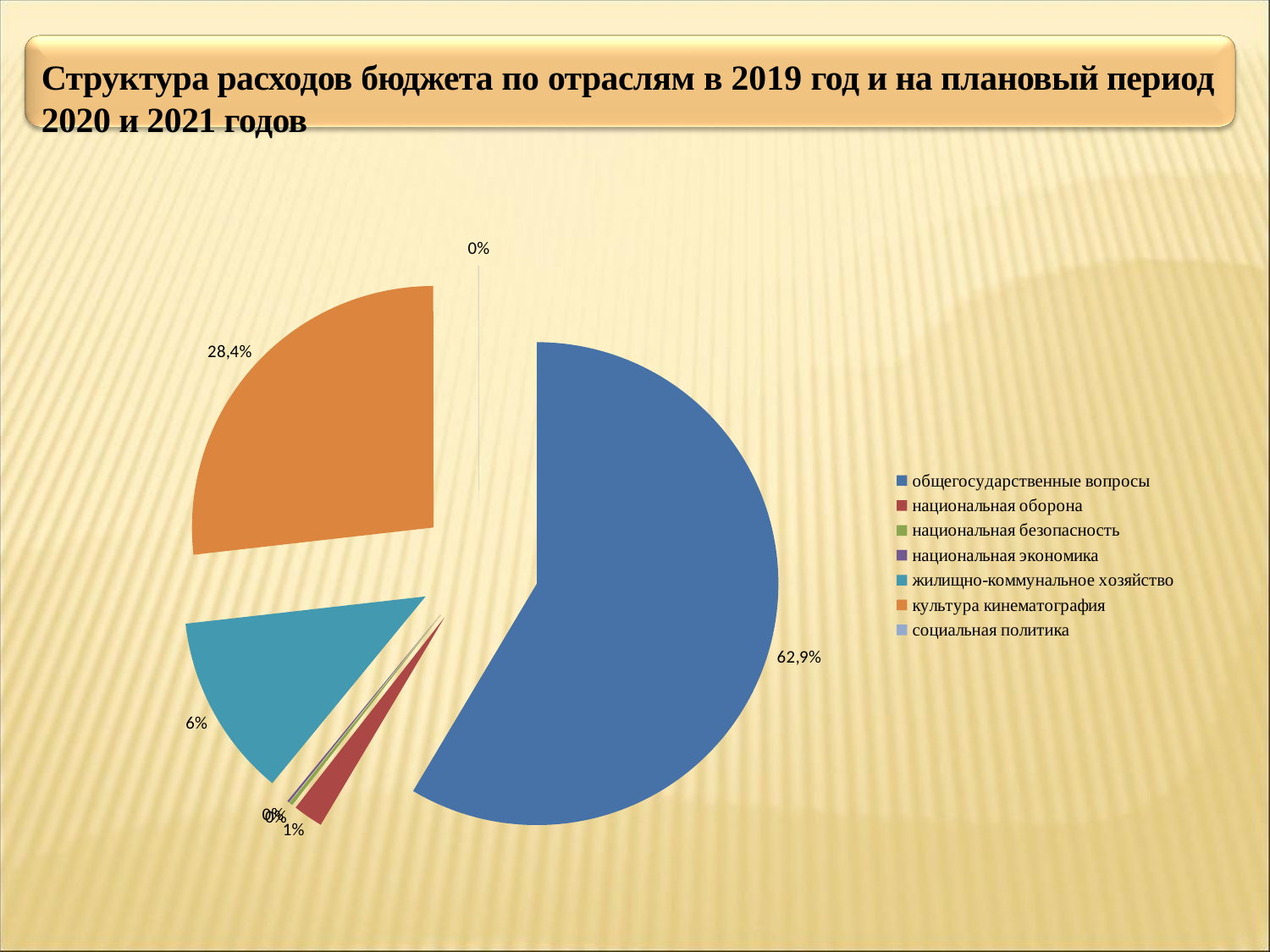
How many categories does the legend list? 7 What colour is the slice for культура кинематография? orange What share of the pie does общегосударственные вопросы take? 62,9% What share of the pie does национальная оборона take? 1% What is the title of the slide? Структура расходов бюджета по отраслям в 2019 год и на плановый период 2020 и 2021 годов What share of the pie does жилищно-коммунальное хозяйство take? 6% What kind of chart is shown on the slide? pie chart Which is larger: the share of культура кинематография or the share of жилищно-коммунальное хозяйство? культура кинематография What share of the pie does культура кинематография take? 28,4% Which category has the largest slice of the pie? общегосударственные вопросы What share of the pie does социальная политика take? 0% What is the difference between the shares of общегосударственные вопросы and культура кинематография? 34,5%